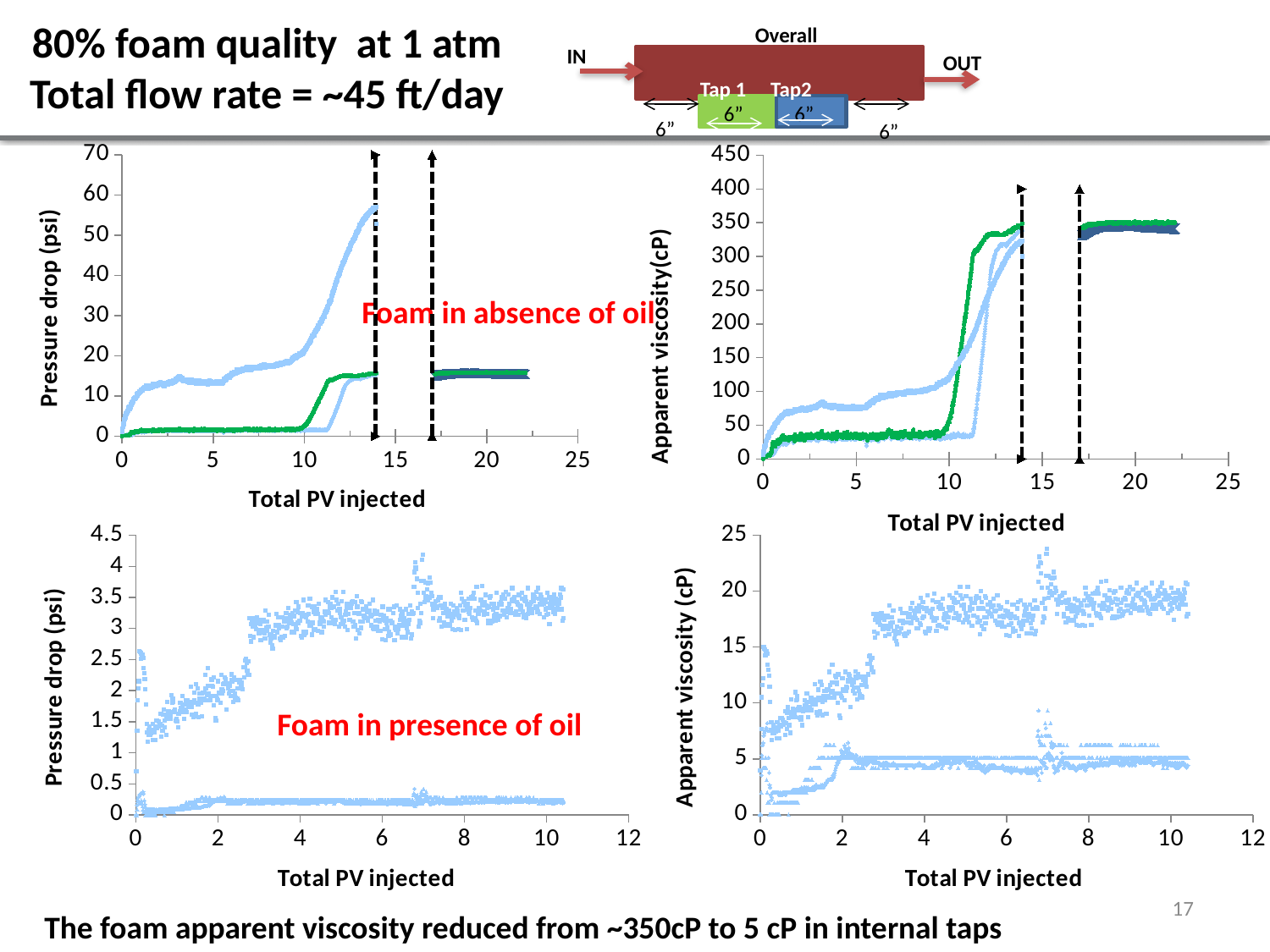
In the bottom-left chart, is the pressure drop of the upper series at 8 PV injected greater or less than 2.5 psi? greater In the top-right chart, is the apparent viscosity of the green series at 5 PV injected greater or less than 100 cP? less What kind of chart is the top-left chart on the slide? scatter chart In the bottom-right chart, is the apparent viscosity of the upper series at 8 PV injected greater or less than 15 cP? greater In the top-left chart, does the light blue series rise or fall between 0 and 14 PV injected? rise In the top-right chart, what is the label of the x axis? Total PV injected In the top-left chart, what is the label of the y axis? Pressure drop (psi) How many charts are shown on the slide? 4